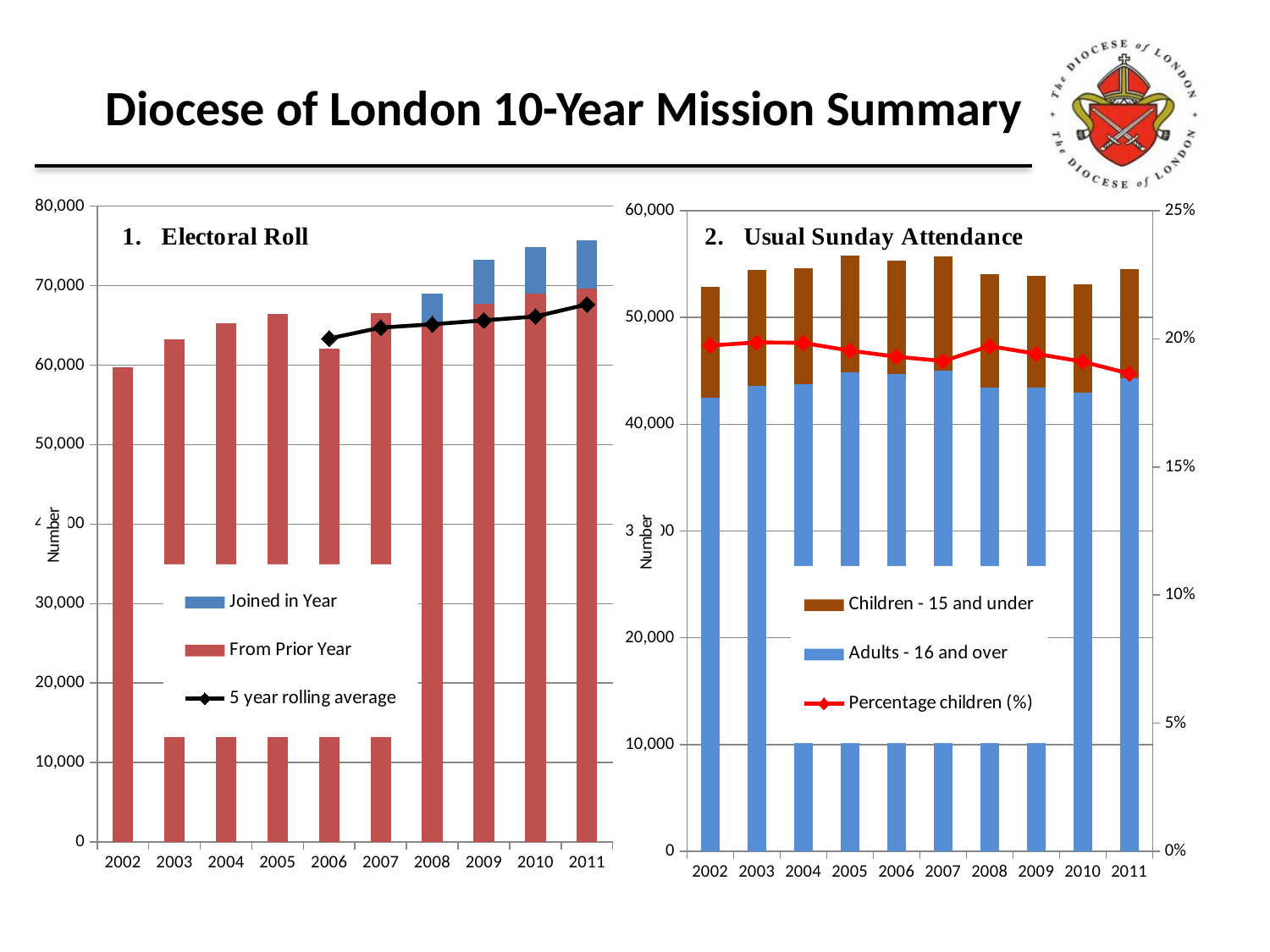
In the Usual Sunday Attendance chart, which colour represents Adults - 16 and over? Blue In the Electoral Roll chart, how many years are shown on the x axis? 10 In the Electoral Roll chart, which year has the lowest total electoral roll? 2002 In the Electoral Roll chart, is the total bar for 2009 greater or less than 70,000? greater In the Electoral Roll chart, how many series does the legend list? 3 In the Usual Sunday Attendance chart, which year has the lowest total attendance? 2002 In the Usual Sunday Attendance chart, is the Percentage children value for 2011 greater or less than 20%? less In the Usual Sunday Attendance chart, does the Percentage children line generally rise or fall from 2003 to 2011? fall In the Electoral Roll chart, which is larger, the total bar for 2009 or the total bar for 2005? 2009 In the Electoral Roll chart, is the 5 year rolling average for 2011 greater or less than 60,000? greater In the Electoral Roll chart, does the total electoral roll generally rise or fall from 2002 to 2011? rise In the Usual Sunday Attendance chart, how many series does the legend list? 3